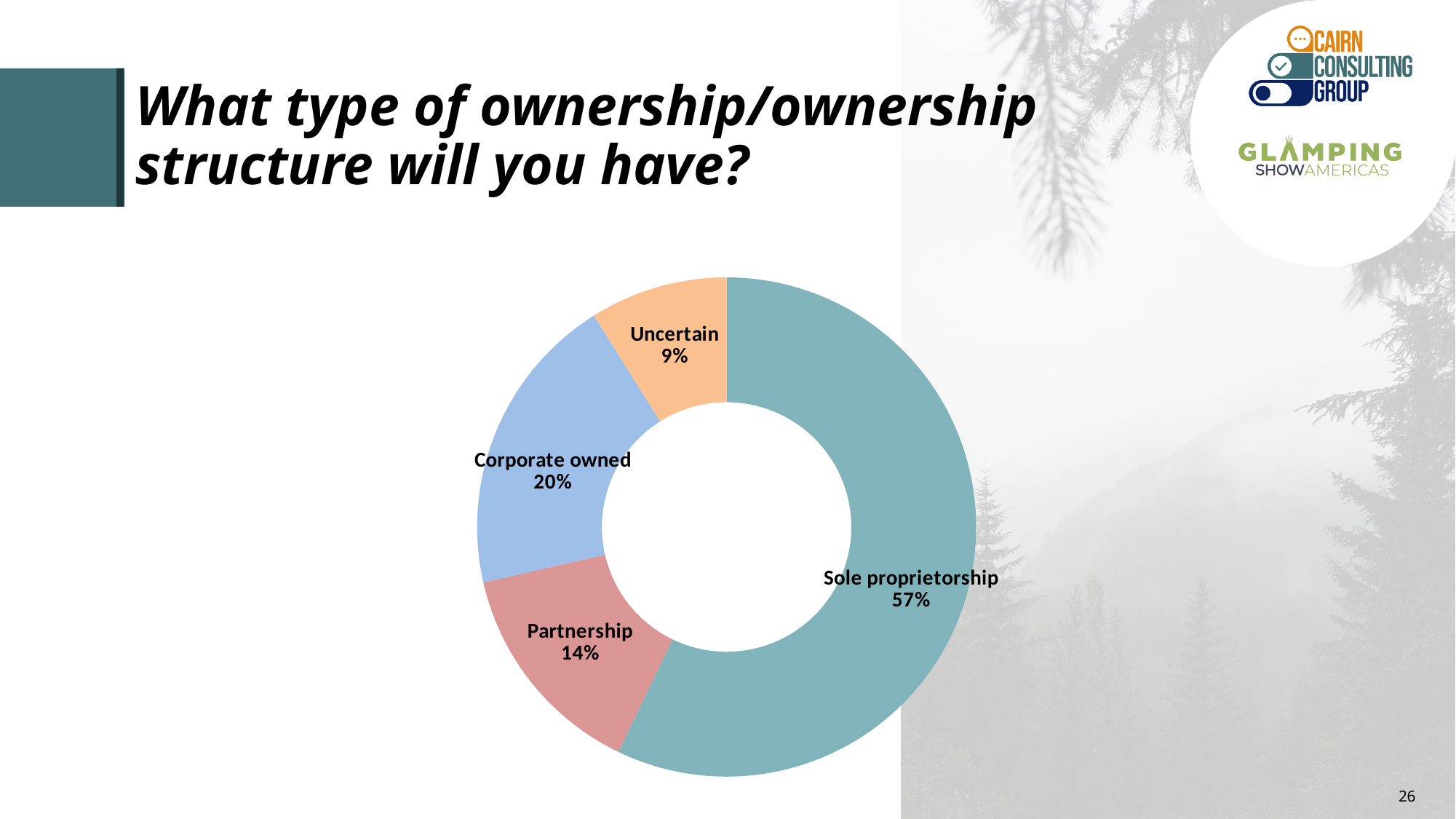
What is the difference in percentage points between Corporate owned and Partnership? 6 What percentage of respondents were Uncertain? 9% Which category has the smallest share? Uncertain What colour is the Partnership segment? Red What percentage of respondents chose Corporate owned? 20% What is the difference in percentage points between Sole proprietorship and Corporate owned? 37 What percentage of respondents chose Sole proprietorship? 57% How many categories are shown in the chart? 4 What kind of chart is shown on the slide? Doughnut chart Which is larger, Partnership or Uncertain? Partnership What percentage of respondents chose Partnership? 14% Which ownership structure has the largest share? Sole proprietorship